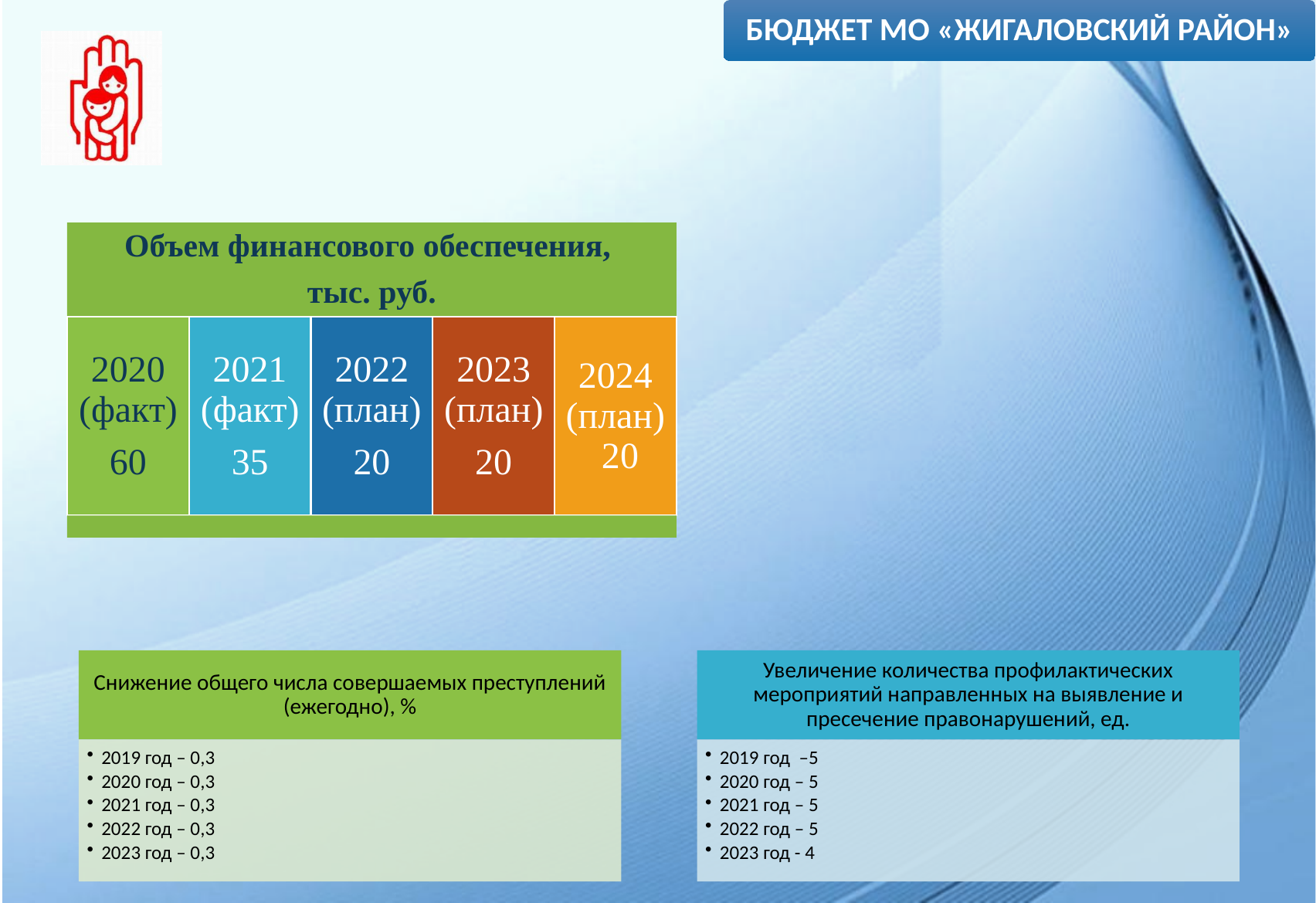
In the "Объем финансового обеспечения, тыс. руб." graphic, how many years are marked as (план)? 3 In the "Объем финансового обеспечения, тыс. руб." graphic, what is the value for 2021 (факт)? 35 How many years are shown in the "Объем финансового обеспечения, тыс. руб." graphic? 5 In the "Объем финансового обеспечения, тыс. руб." graphic, what is the planned value for 2024? 20 What is the total of the values for 2022, 2023 and 2024 (план) in the "Объем финансового обеспечения, тыс. руб." graphic? 60 In the "Объем финансового обеспечения, тыс. руб." graphic, what is the difference between the 2021 (факт) and 2022 (план) values? 15 In the "Объем финансового обеспечения, тыс. руб." graphic, what is the value for 2020 (факт)? 60 In the "Объем финансового обеспечения, тыс. руб." graphic, what is the difference between the 2020 (факт) and 2021 (факт) values? 25 What unit is stated in the title of the "Объем финансового обеспечения" graphic? тыс. руб. In the "Объем финансового обеспечения, тыс. руб." graphic, which year has the highest value? 2020 (факт) In the "Объем финансового обеспечения, тыс. руб." graphic, which is larger: the value for 2020 (факт) or for 2022 (план)? 2020 (факт) In the "Объем финансового обеспечения, тыс. руб." graphic, do the values rise or fall from 2020 to 2022? fall